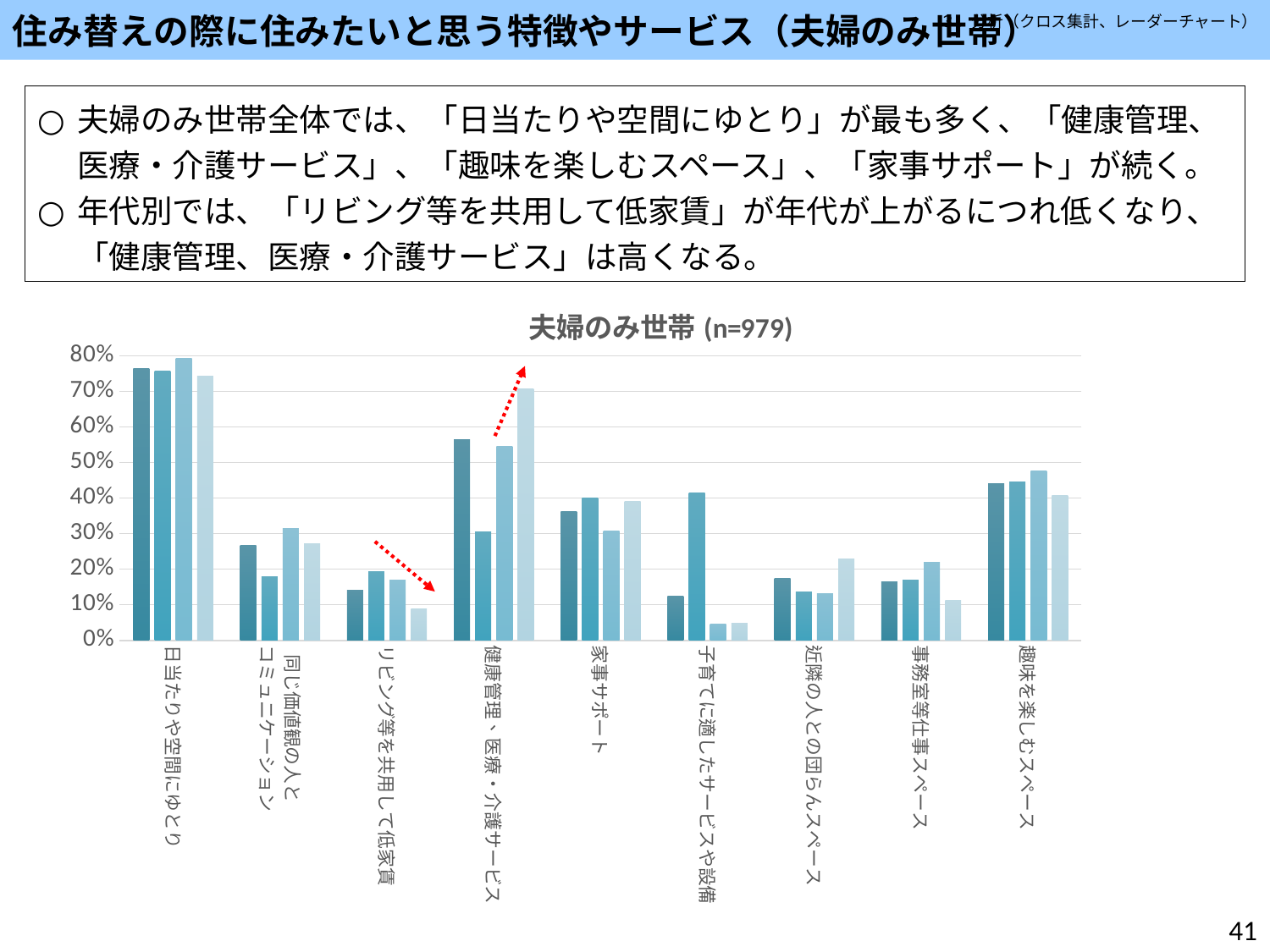
What is the title of the chart? 夫婦のみ世帯 (n=979) How many categories are shown along the x axis of the chart? 9 Which category has higher bars overall, 日当たりや空間にゆとり or 趣味を楽しむスペース? 日当たりや空間にゆとり Is the tallest bar for 家事サポート greater or less than 50%? less What kind of chart is shown on the slide? bar chart Which category has the tallest bars in the chart? 日当たりや空間にゆとり Is the shortest bar for 日当たりや空間にゆとり greater or less than 70%? greater How many bars are plotted for each category in the chart? 4 Is the tallest bar for 健康管理、医療・介護サービス greater or less than 60%? greater Which category has the taller maximum bar, 家事サポート or 趣味を楽しむスペース? 趣味を楽しむスペース Which category contains the shortest bar in the chart? 子育てに適したサービスや設備